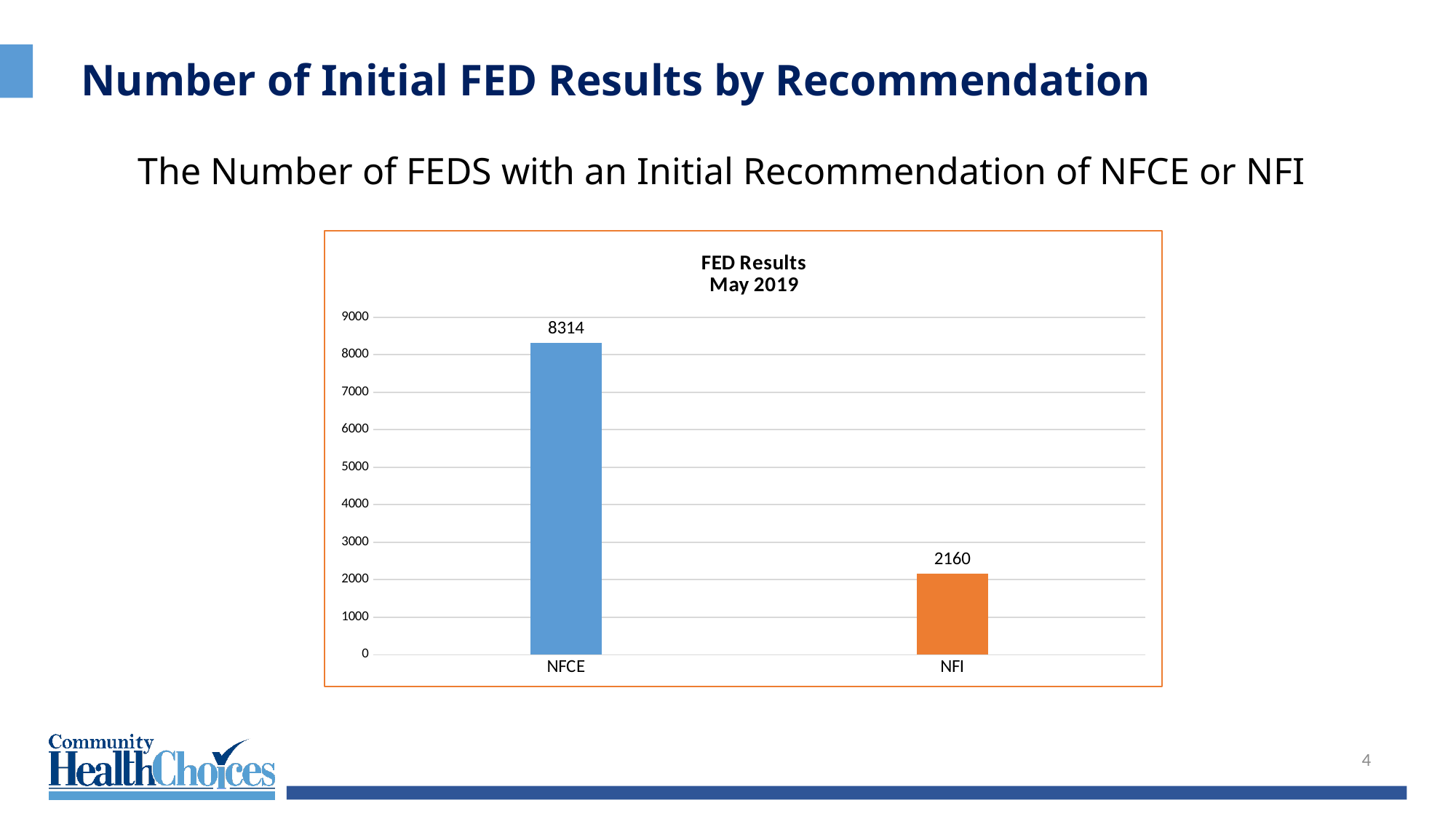
Which category has the lowest value? NFI What is the difference between the NFCE and NFI values? 6154 What kind of chart is shown on the slide? bar chart Is the value for NFCE greater or less than 8000? greater How many categories are shown on the x axis? 2 What is the value for NFI? 2160 Which is larger, the value for NFCE or the value for NFI? NFCE Is the value for NFI greater or less than 3000? less What is the title of the chart? FED Results May 2019 What is the value for NFCE? 8314 Which category has the highest value? NFCE What colour is the bar for NFI? orange